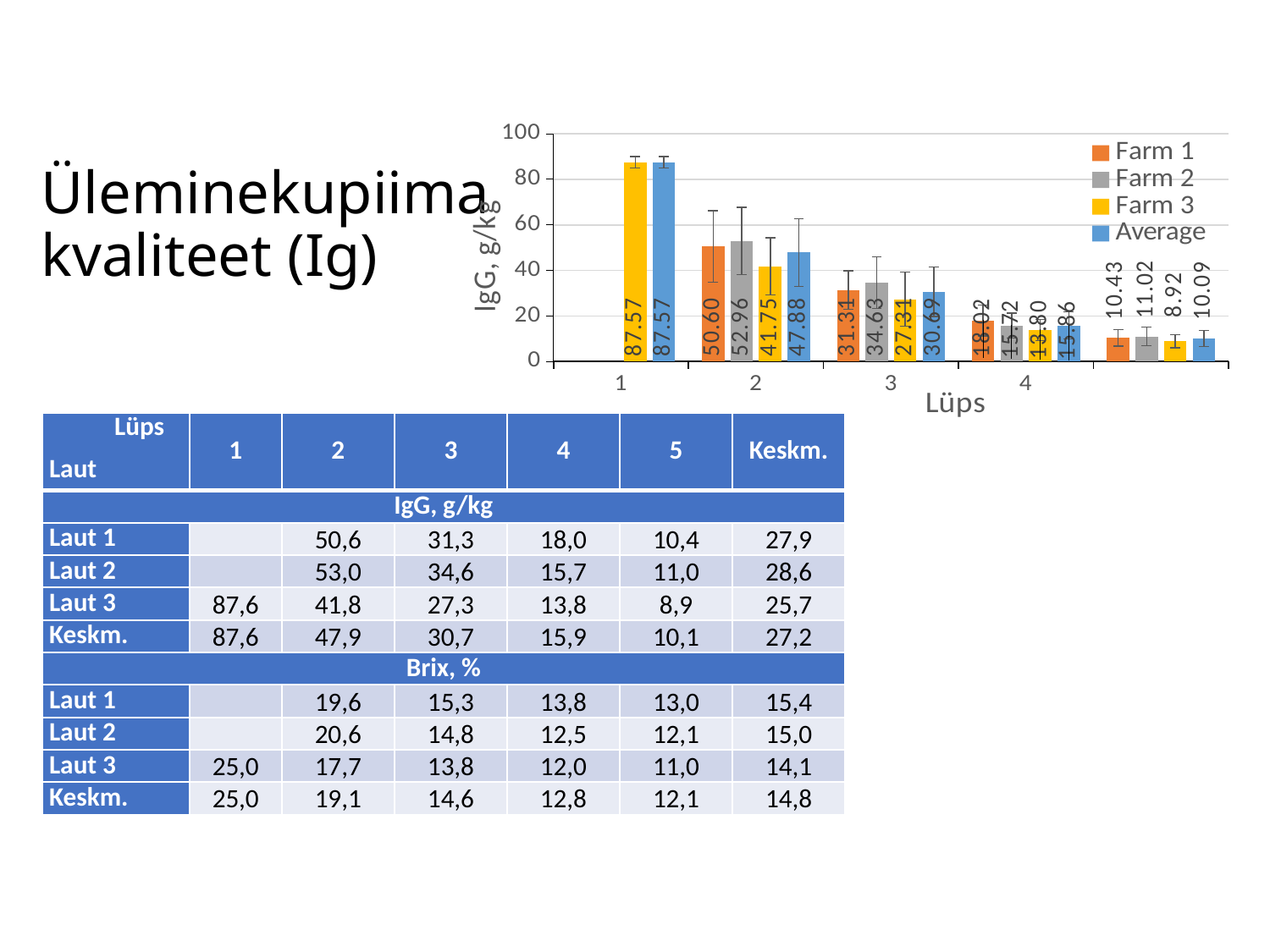
What is the difference between the Farm 1 and Farm 3 values at Lüps 2? 8.85 Is the Average value at Lüps 2 greater or less than 40? greater What kind of chart is shown on the slide? bar chart What is the Average value at Lüps 3? 30.69 Which series has the lowest value at Lüps 3? Farm 3 What is the title of the chart's vertical axis? IgG, g/kg How many series does the chart legend list? 4 Which series has the highest value at Lüps 2? Farm 2 At Lüps 4, which is larger: Farm 1 or Farm 2? Farm 1 What is the value for Farm 2 at Lüps 2? 52.96 What is the value for Farm 3 at Lüps 1? 87.57 Do the Average values rise or fall from Lüps 1 to Lüps 4? fall